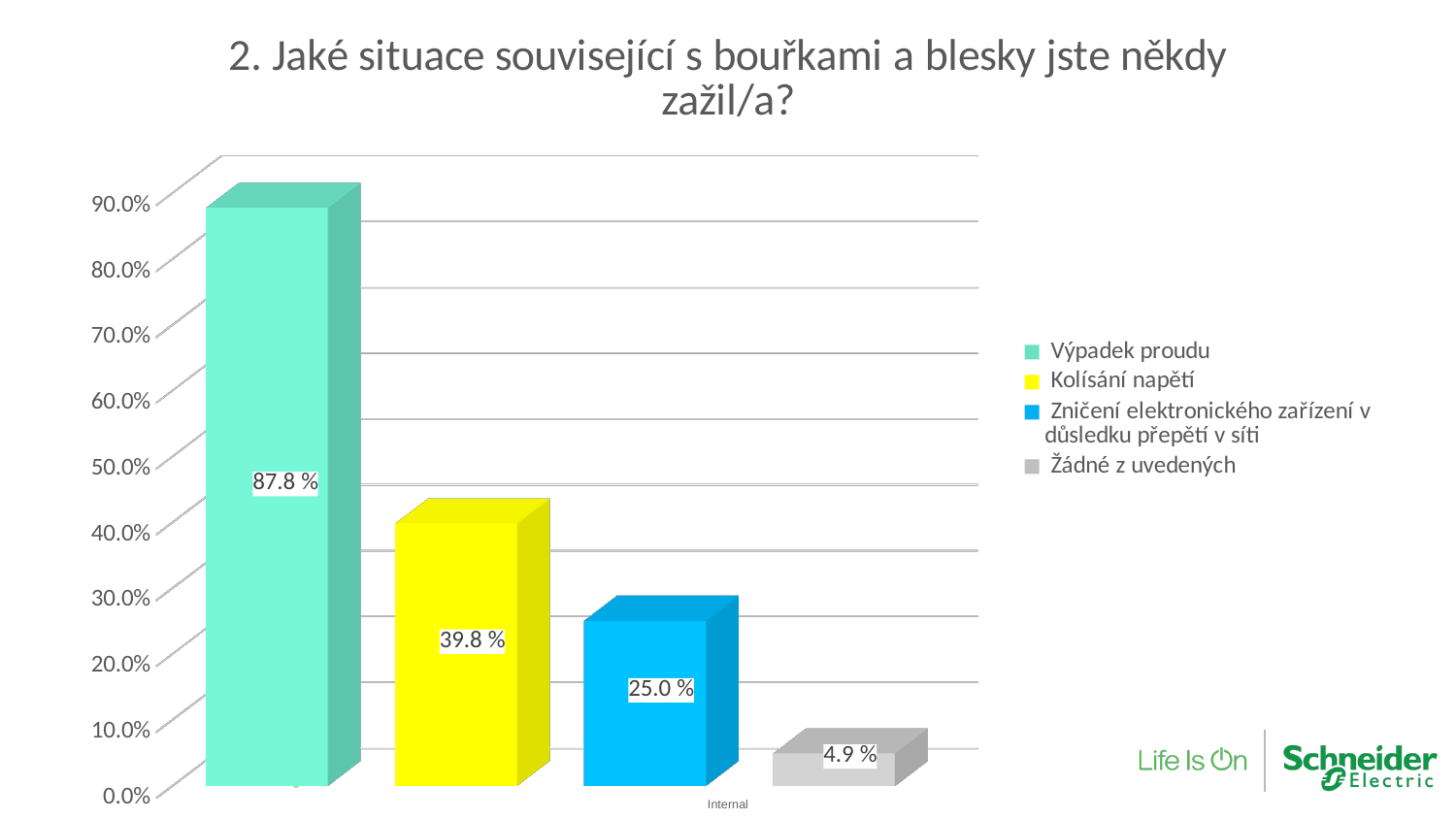
Is the value for Výpadek proudu greater or less than 80.0%? greater What kind of chart is shown on the slide? bar chart How many entries does the legend list? 4 What is the value for Žádné z uvedených? 4.9 % What is the value for Výpadek proudu? 87.8 % How many bars are plotted in the chart? 4 What is the value for Kolísání napětí? 39.8 % What is the value for Zničení elektronického zařízení v důsledku přepětí v síti? 25.0 % Which is larger, the value for Kolísání napětí or the value for Zničení elektronického zařízení v důsledku přepětí v síti? Kolísání napětí Which category has the lowest value? Žádné z uvedených Which category has the highest value? Výpadek proudu What is the difference between the values for Výpadek proudu and Kolísání napětí? 48.0 %